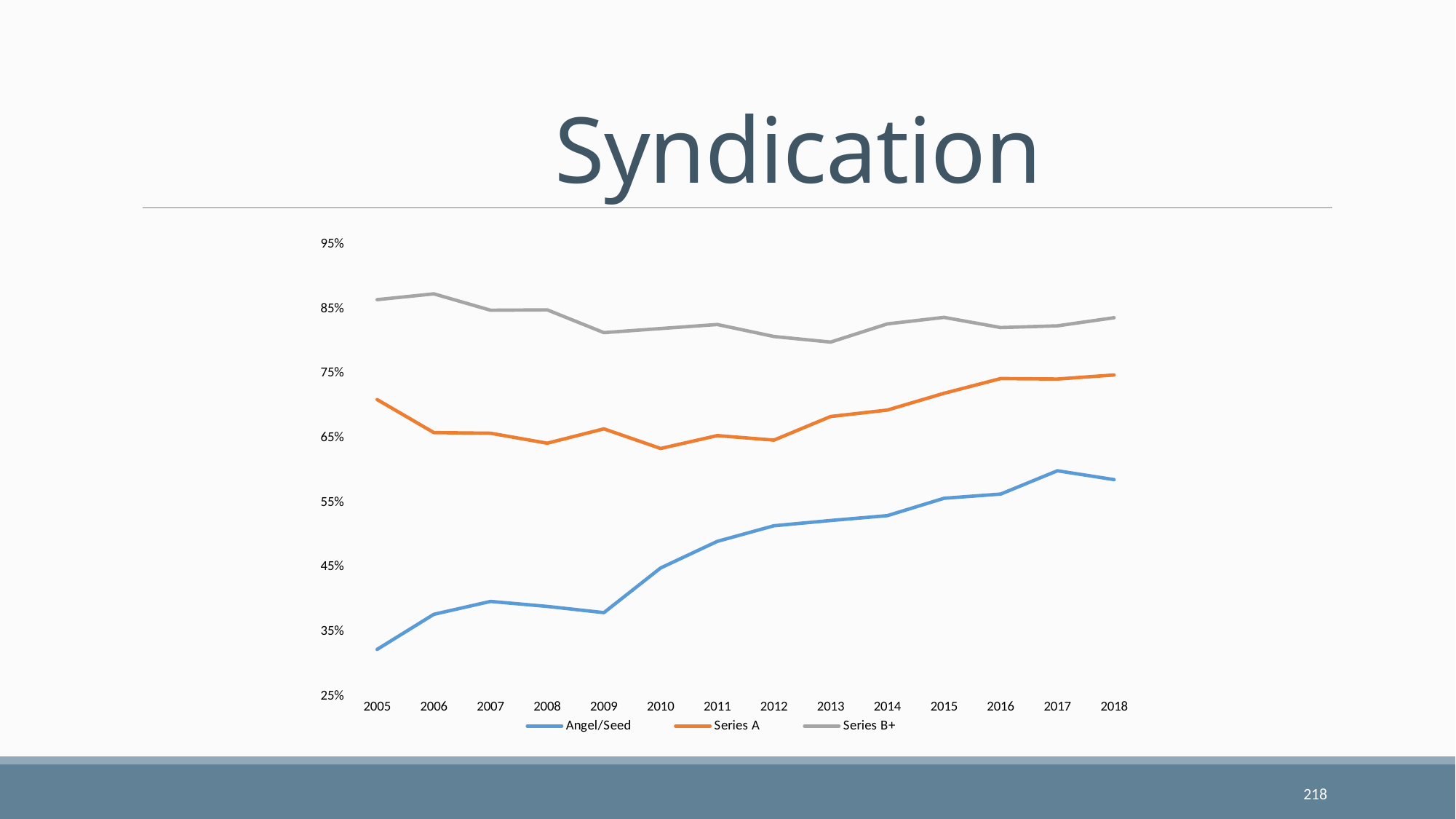
How many series does the legend list? 3 What kind of chart is shown on the slide? line chart How many years are plotted along the x axis? 14 Which series is drawn in orange? Series A Is the value for Series A in 2010 greater or less than 65%? less Is the value for Series B+ in 2006 greater or less than 85%? greater In which year does the Angel/Seed series reach its highest value? 2017 Does the Angel/Seed line generally rise or fall from 2005 to 2018? rise Is the value for Angel/Seed in 2005 greater or less than 35%? less What is the title of the slide containing the chart? Syndication In 2010, which is larger: the value for Series B+ or the value for Angel/Seed? Series B+